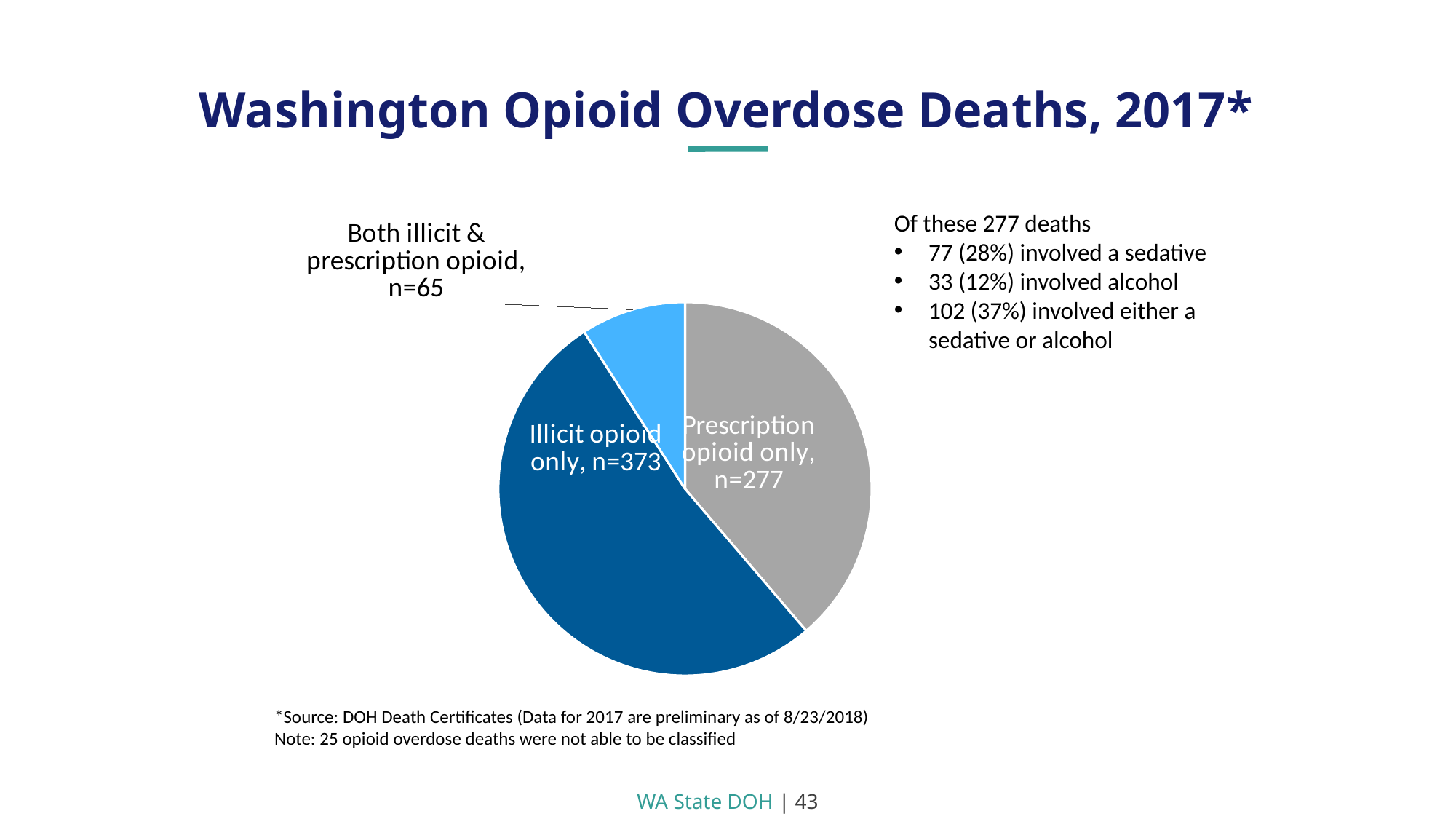
How many slices does the pie chart have? 3 How many more deaths were 'Illicit opioid only' than 'Prescription opioid only'? 96 What is the number of deaths for the 'Prescription opioid only' slice? n=277 What is the number of deaths for the 'Illicit opioid only' slice? n=373 What is the total number of deaths across all three slices of the pie? 715 Which is larger: 'Prescription opioid only' or 'Both illicit & prescription opioid'? Prescription opioid only How many more deaths were 'Prescription opioid only' than 'Both illicit & prescription opioid'? 212 Which category has the largest slice of the pie? Illicit opioid only What colour is the 'Prescription opioid only' slice? grey What is the number of deaths for the 'Both illicit & prescription opioid' slice? n=65 Which category has the smallest slice of the pie? Both illicit & prescription opioid What kind of chart is shown on the slide? pie chart